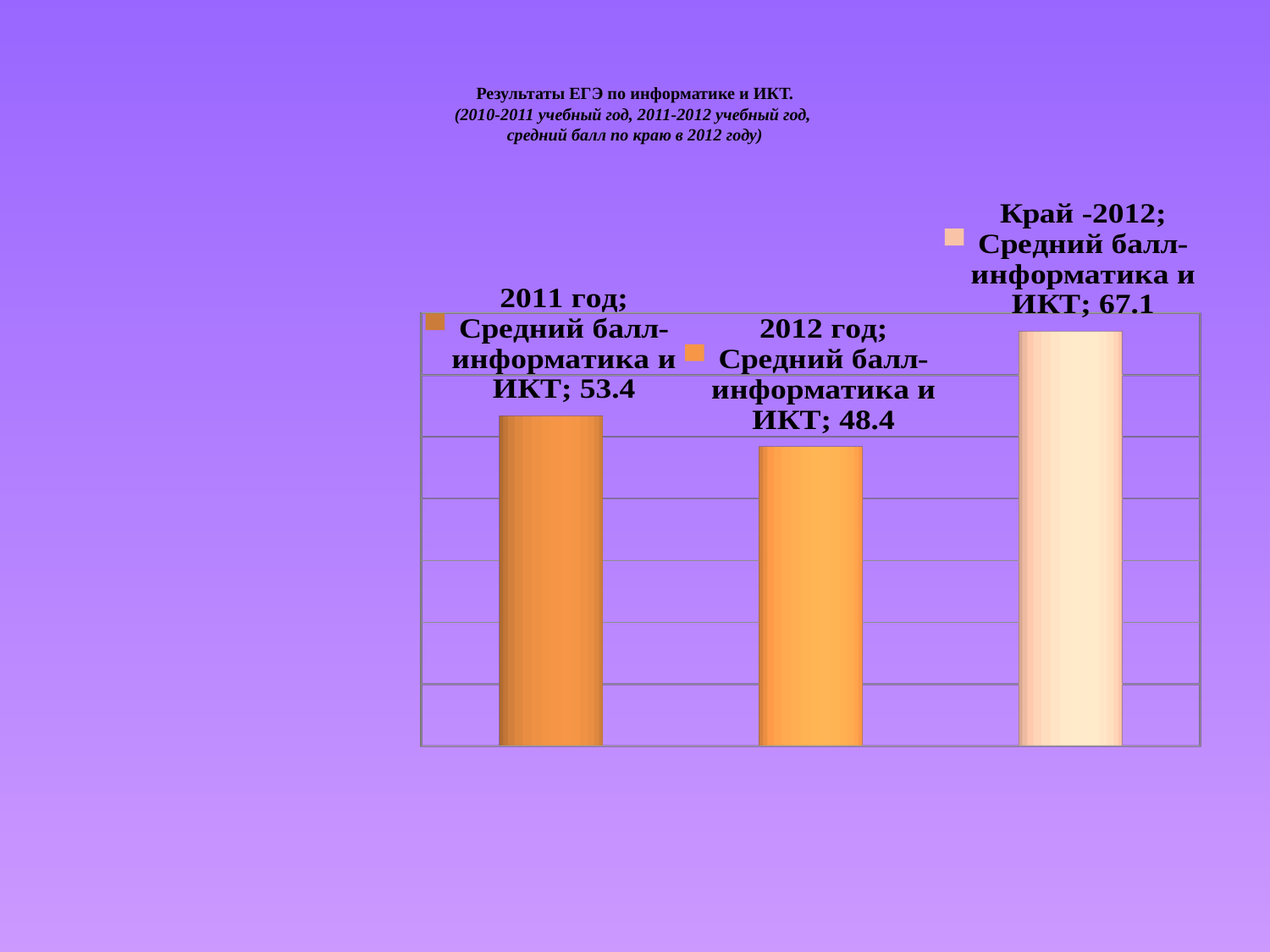
What is the average score for 2012 год? 48.4 Did the average score rise or fall from 2011 год to 2012 год? fall What is the average score for Край -2012? 67.1 What kind of chart is shown on the slide? bar chart Which category has the highest average score? Край -2012 Which category has the lowest average score? 2012 год How many bars are shown in the chart? 3 Which is larger, the score for 2011 год or for 2012 год? 2011 год What subject do the ЕГЭ results in the chart title refer to? информатика и ИКТ What is the difference between the scores for 2011 год and 2012 год? 5 What is the average score for 2011 год? 53.4 What is the difference between the scores for Край -2012 and 2012 год? 18.7